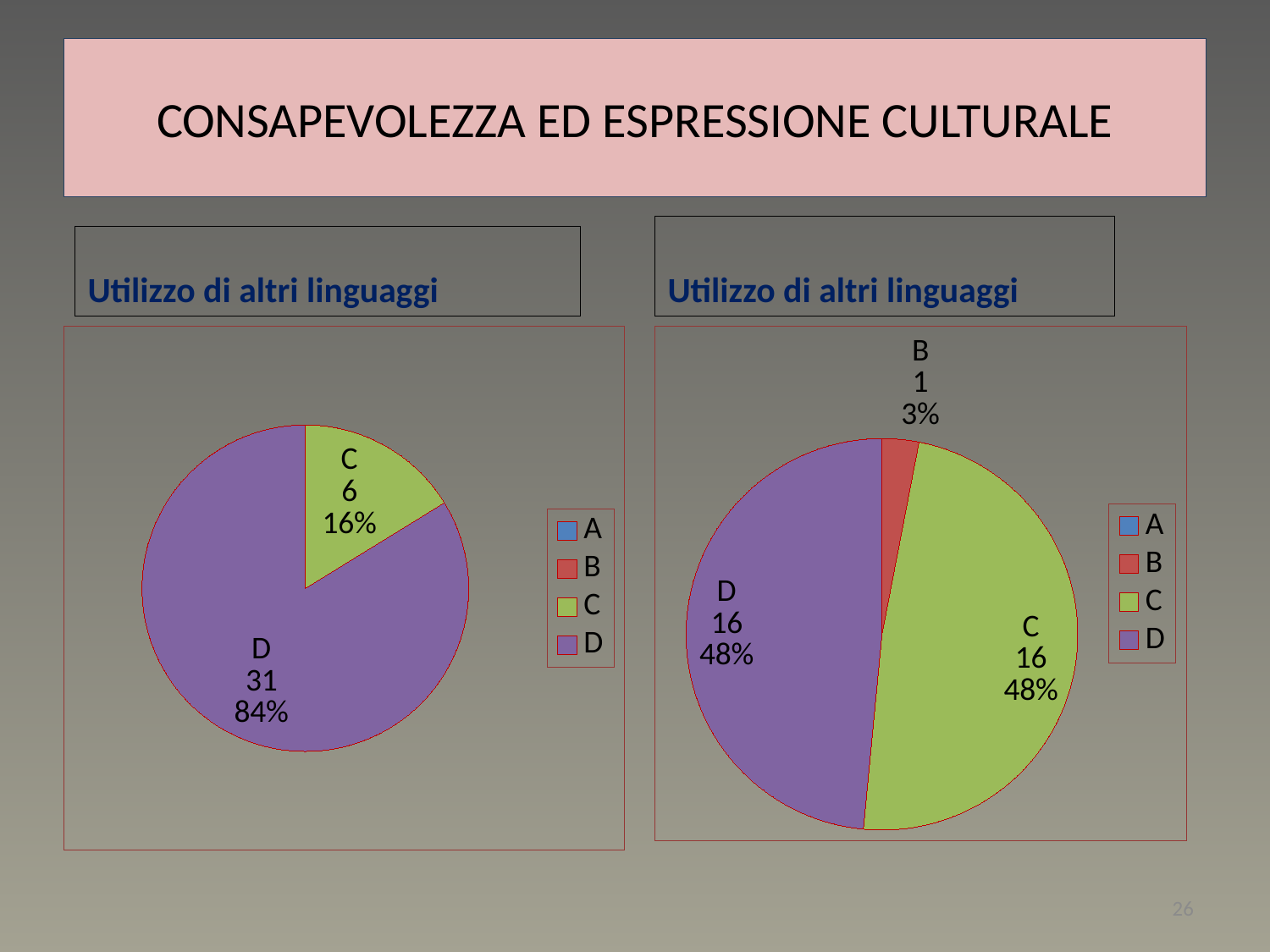
How many entries does the legend of the left chart list? 4 In the pie chart on the right, which is larger, the value for B or the value for C? C What is the title shown above the pie chart on the right? Utilizzo di altri linguaggi In the pie chart on the left, what share of the pie does C represent? 16% In the pie chart on the right, which category has the smallest slice? B In the pie chart on the right, what is the difference between the values for C and B? 15 What kind of chart is the chart on the left of the slide? pie chart In the pie chart on the right, what share of the pie does D represent? 48% In the pie chart on the left, what is the value for D? 31 In the pie chart on the left, which category has the largest slice? D In the pie chart on the right, what is the value for B? 1 In the pie chart on the left, what is the difference between the values for D and C? 25